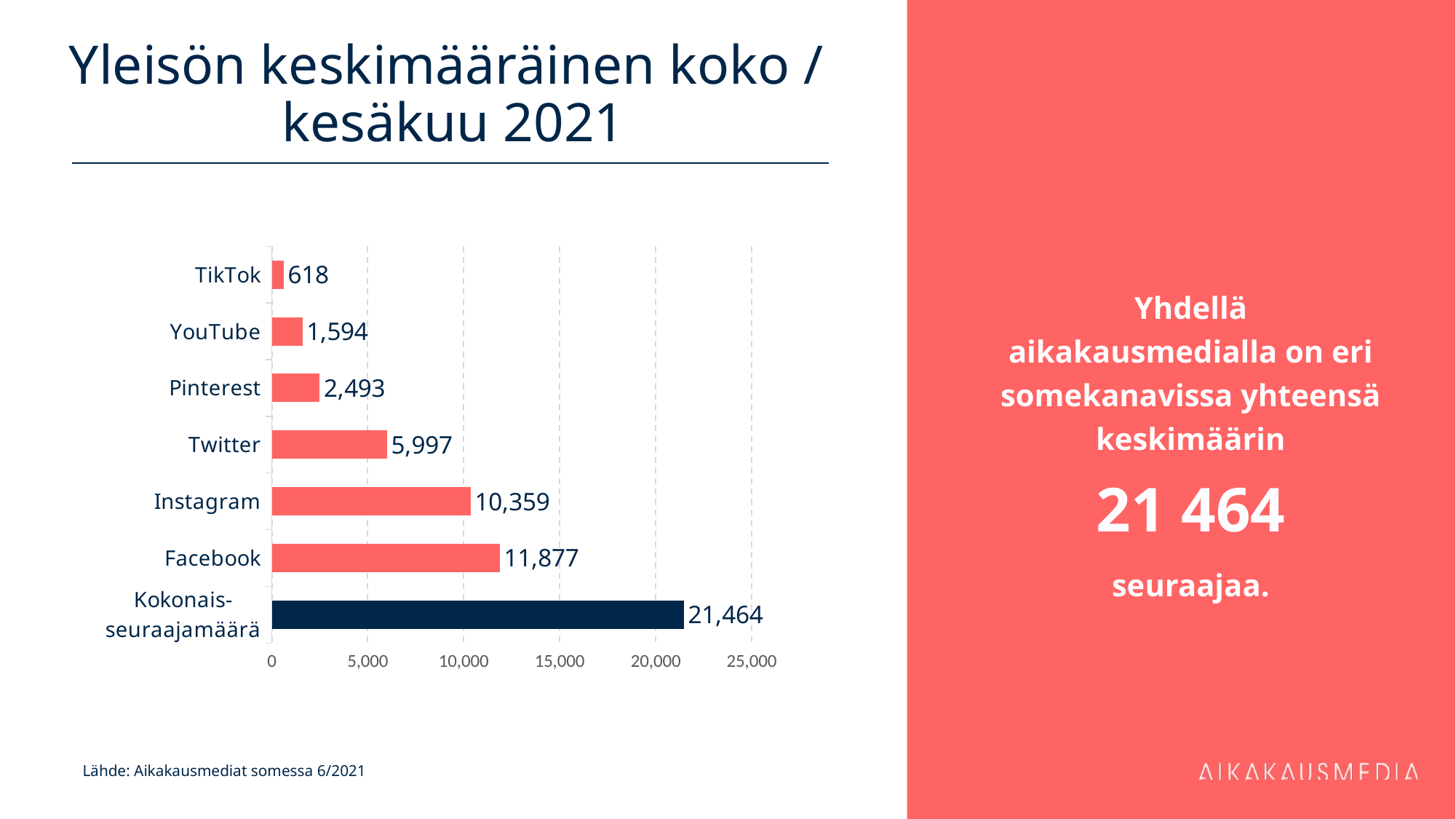
What is the value for TikTok? 618 What kind of chart is shown on the slide? bar chart How many categories are shown in the chart? 7 What is the value for Kokonais-seuraajamäärä? 21,464 What is the difference between the values for Facebook and Instagram? 1,518 What is the title of the chart? Yleisön keskimääräinen koko / kesäkuu 2021 Which category has the highest value? Kokonais-seuraajamäärä Which category has the lowest value? TikTok What is the value for Facebook? 11,877 Is the value for YouTube greater or less than 5,000? less Which is larger, the value for Twitter or the value for Pinterest? Twitter What is the value for Instagram? 10,359